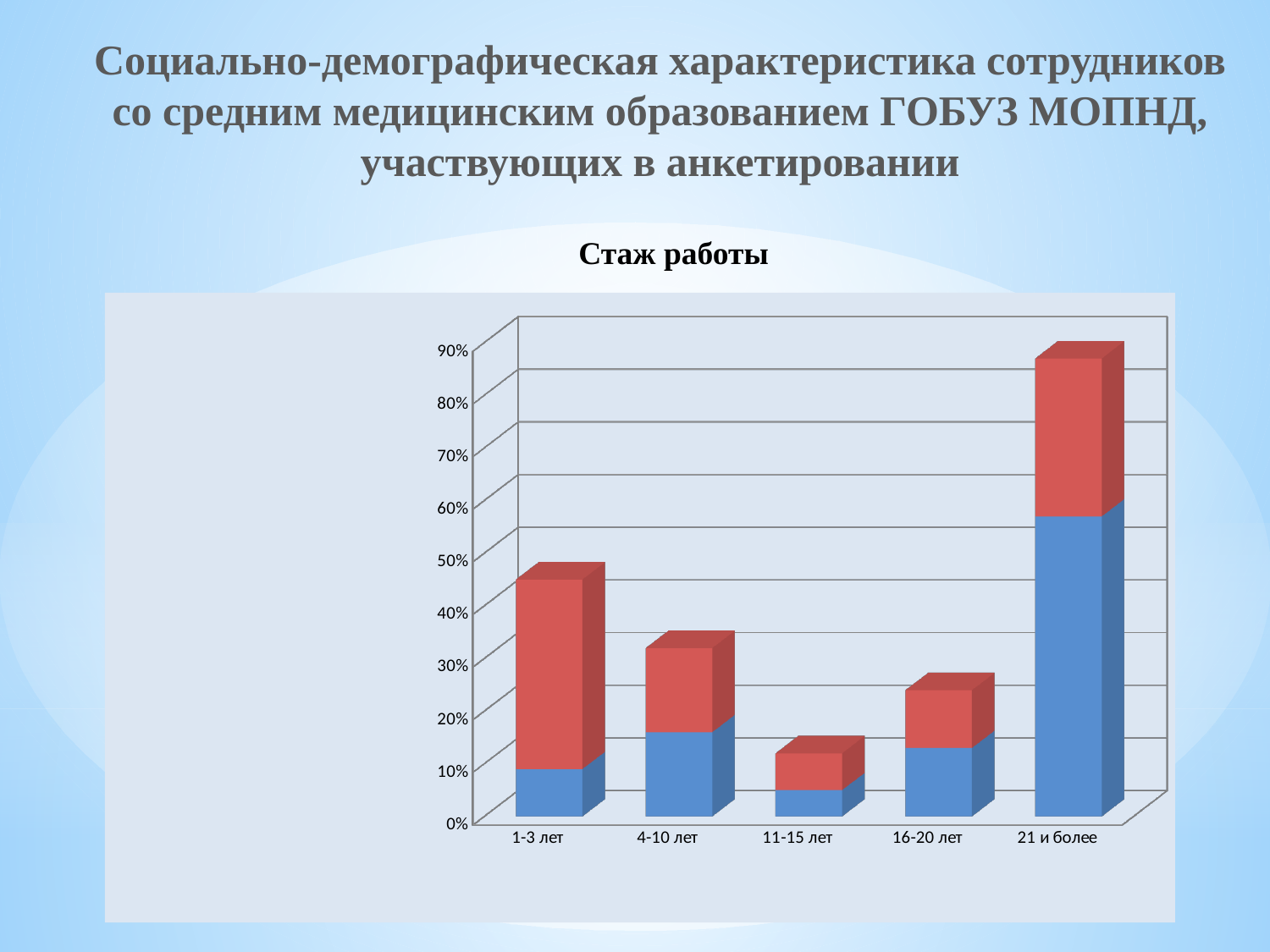
How many categories are shown on the x axis of the chart? 5 Which category has the shortest stacked bar? 11-15 лет Which stacked bar is taller, 4-10 лет or 16-20 лет? 4-10 лет Is the total value for 11-15 лет greater or less than 20%? less Which category has the tallest stacked bar? 21 и более Is the total value for 21 и более greater or less than 80%? greater What kind of chart is shown on the slide? bar chart Is the total value for 16-20 лет greater or less than 30%? less Which stacked bar is taller, 1-3 лет or 4-10 лет? 1-3 лет What is the highest value shown on the vertical axis of the chart? 90% What is the title of the chart? Стаж работы